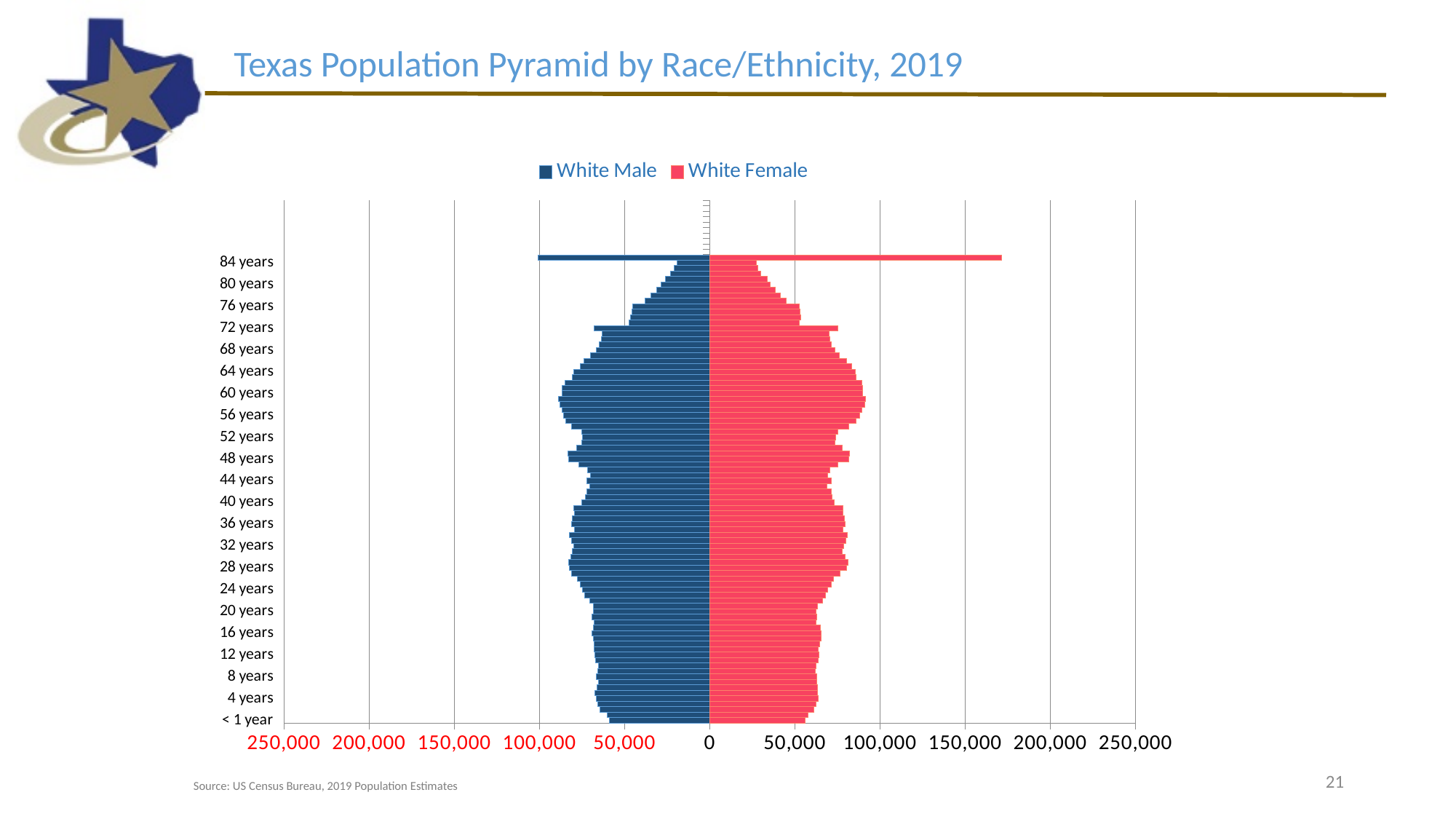
Is the White Female value at 60 years greater or less than 50,000? greater Is the White Female value at 84 years greater or less than 150,000? less How many series does the legend list? 2 Is the White Male value at 60 years greater or less than 100,000? less What kind of chart is shown on the slide? Bar chart (population pyramid) What is the title of the chart on the slide? Texas Population Pyramid by Race/Ethnicity, 2019 Moving from 60 years up to 80 years, do the White Male bars get longer or shorter? shorter What are the two series named in the legend? White Male and White Female At 84 years, which is larger, the White Male value or the White Female value? White Female